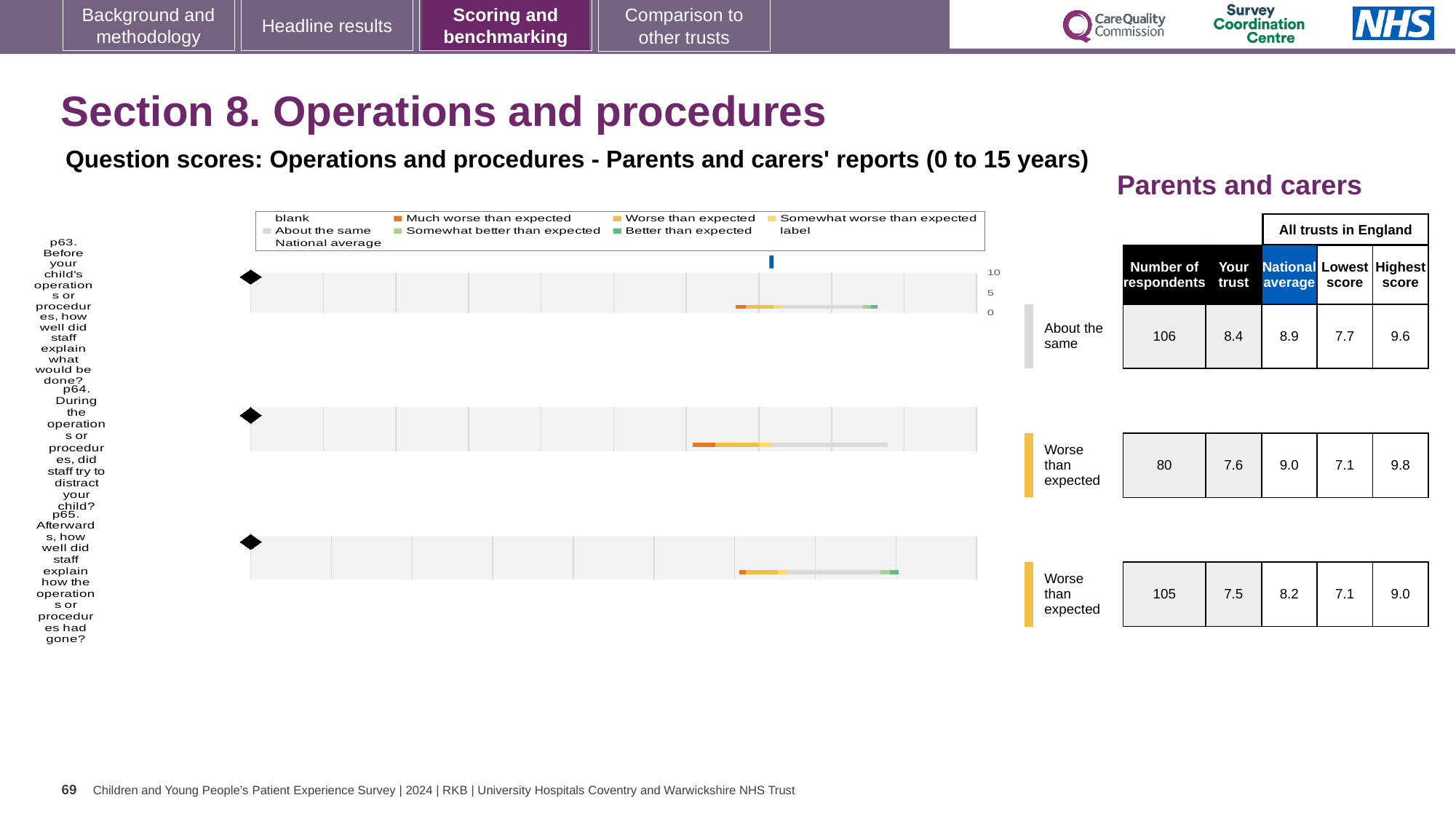
How many questions (bars) are plotted in the chart? 3 What is the 'Your trust' score for p63 (Before your child's operations or procedures, how well did staff explain what would be done?)? 8.4 Which question has the lowest 'Your trust' score? p65 What type of chart is shown on the slide? bar chart What is the difference between the national average and the 'Your trust' score for p64? 1.4 What is the highest score across all trusts in England for p64? 9.8 What is the national average score for p64 (During the operations or procedures, did staff try to distract your child?)? 9.0 How many respondents answered p65 (Afterwards, how well did staff explain how the operations or procedures had gone?)? 105 For p63, which is larger: the 'Your trust' score or the national average? National average Which question has the highest 'Your trust' score? p63 What benchmark category is shown for p63? About the same What benchmark category is shown for p65? Worse than expected